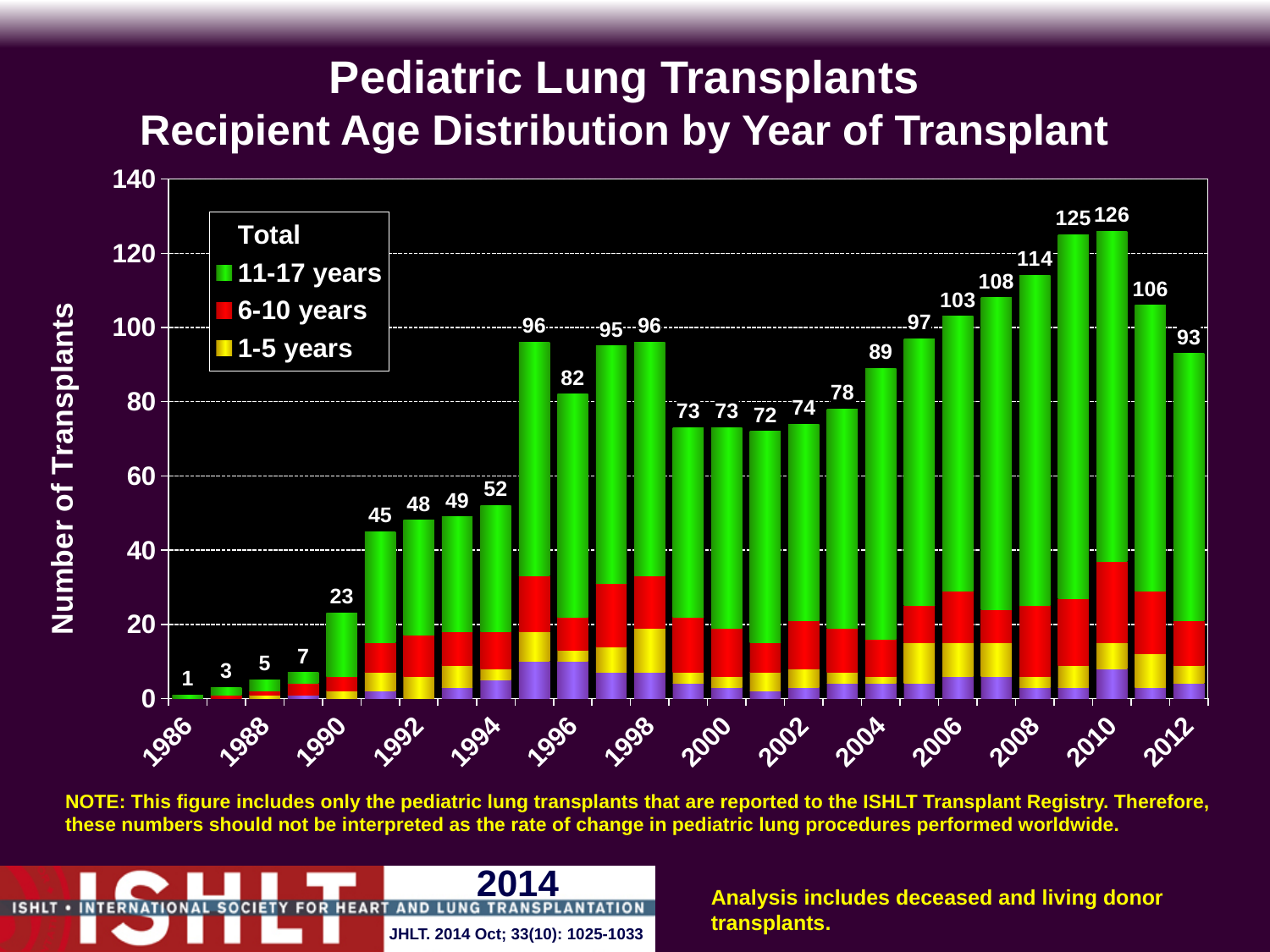
What is the difference between the total for 2010 and the total for 2012? 33 How many age groups does the legend list? 3 What is the total number of transplants shown for 1990? 23 What type of chart is shown on the slide? Stacked bar chart What is the total number of pediatric lung transplants shown for 2008? 114 Which year has the highest total number of transplants? 2010 What is the label on the vertical axis? Number of Transplants Which year has the lowest total number of transplants? 1986 How many years (bars) are plotted on the chart? 27 Which year has a larger total, 1996 or 1998? 1998 Do the total transplant numbers rise or fall from 2004 to 2010? Rise Is the 11-17 years segment for 2012 greater or less than 60? greater